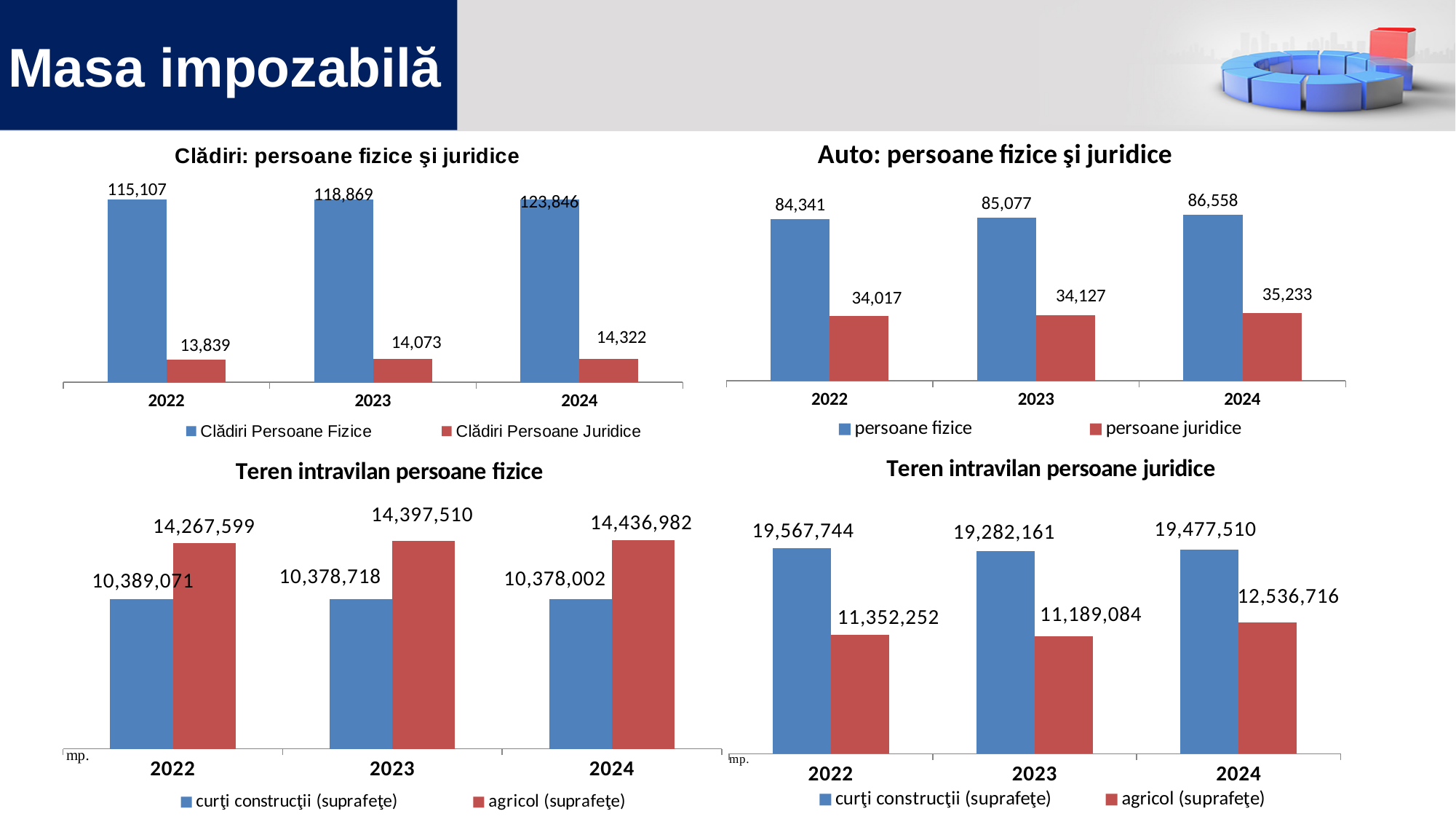
In the chart titled "Auto: persoane fizice şi juridice", what is the value for persoane juridice in 2023? 34,127 In the chart titled "Teren intravilan persoane juridice", what is the value for curţi construcţii (suprafeţe) in 2023? 19,282,161 In the chart titled "Clădiri: persoane fizice şi juridice", do the Clădiri Persoane Juridice values rise or fall from 2022 to 2024? rise In the chart titled "Teren intravilan persoane fizice", what is the value for agricol (suprafeţe) in 2023? 14,397,510 In the chart titled "Teren intravilan persoane juridice", what is the difference between curţi construcţii (suprafeţe) and agricol (suprafeţe) in 2024? 6,940,794 How many charts are shown on the slide? 4 In the chart titled "Auto: persoane fizice şi juridice", what is the difference between persoane fizice and persoane juridice in 2022? 50,324 In the chart titled "Teren intravilan persoane fizice", in which year is the curţi construcţii (suprafeţe) value lowest? 2024 In the chart titled "Clădiri: persoane fizice şi juridice", what is the difference between Clădiri Persoane Fizice and Clădiri Persoane Juridice in 2024? 109,524 In the chart titled "Auto: persoane fizice şi juridice", in which year is the persoane fizice value highest? 2024 In the chart titled "Clădiri: persoane fizice şi juridice", what is the value for Clădiri Persoane Fizice in 2024? 123,846 In the chart titled "Teren intravilan persoane fizice", which is larger in 2022: curţi construcţii (suprafeţe) or agricol (suprafeţe)? agricol (suprafeţe)